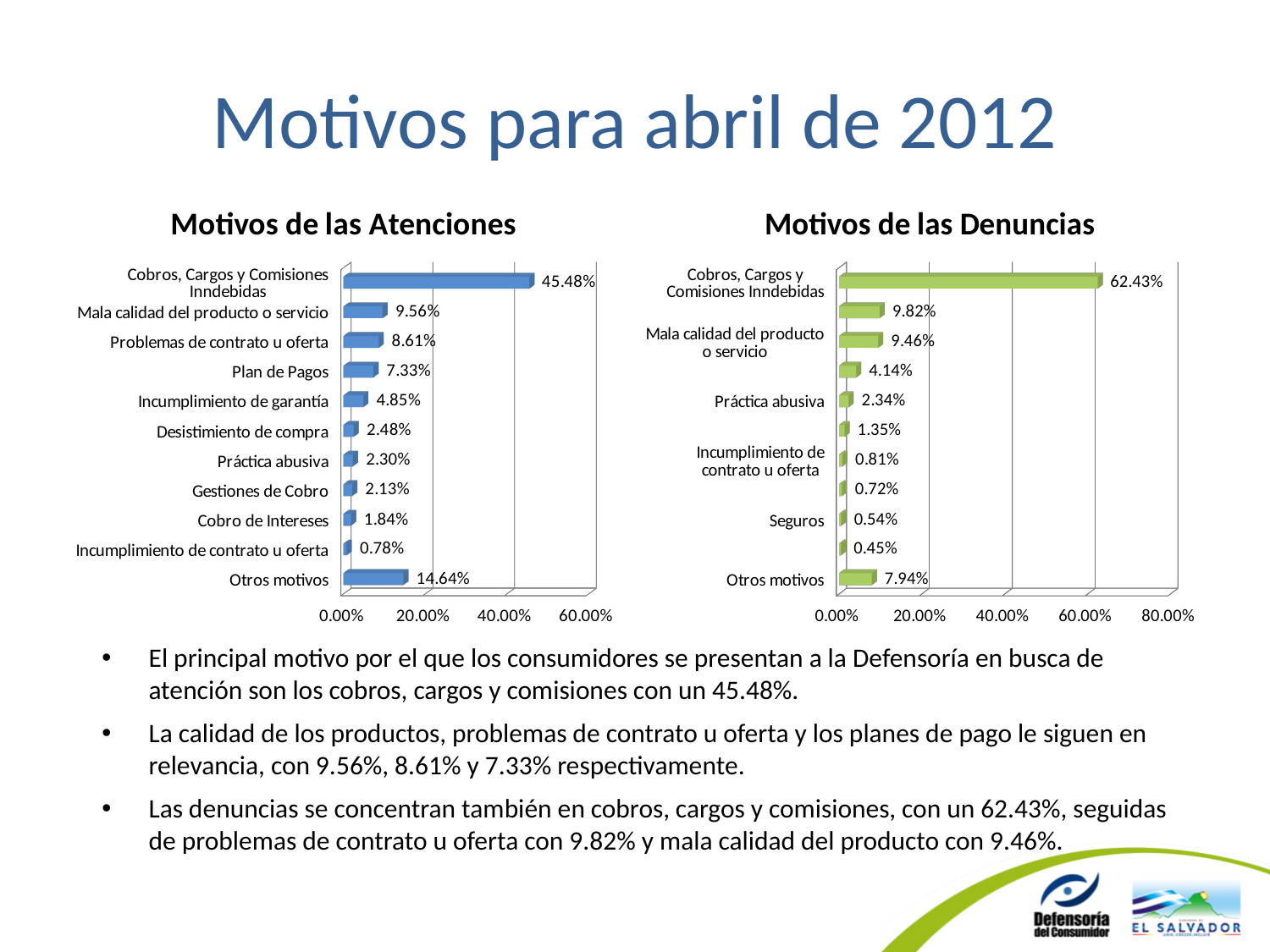
In the 'Motivos de las Denuncias' chart, which is larger: Práctica abusiva or Incumplimiento de contrato u oferta? Práctica abusiva In the 'Motivos de las Denuncias' chart, what is the value for Seguros? 0.54% In the 'Motivos de las Denuncias' chart, what is the value for Cobros, Cargos y Comisiones Inndebidas? 62.43% What type of chart is 'Motivos de las Atenciones'? Bar chart In the 'Motivos de las Atenciones' chart, which category has the lowest value? Incumplimiento de contrato u oferta In the 'Motivos de las Atenciones' chart, what is the difference between Mala calidad del producto o servicio and Problemas de contrato u oferta? 0.95% What is the title of the chart on the right side of the slide? Motivos de las Denuncias In the 'Motivos de las Denuncias' chart, is the value for Cobros, Cargos y Comisiones Inndebidas greater or less than 60.00%? greater In the 'Motivos de las Atenciones' chart, what is the value for Cobros, Cargos y Comisiones Inndebidas? 45.48% In the 'Motivos de las Denuncias' chart, what is the value for Otros motivos? 7.94% In the 'Motivos de las Atenciones' chart, what is the value for Plan de Pagos? 7.33% In the 'Motivos de las Atenciones' chart, how many categories are shown? 11